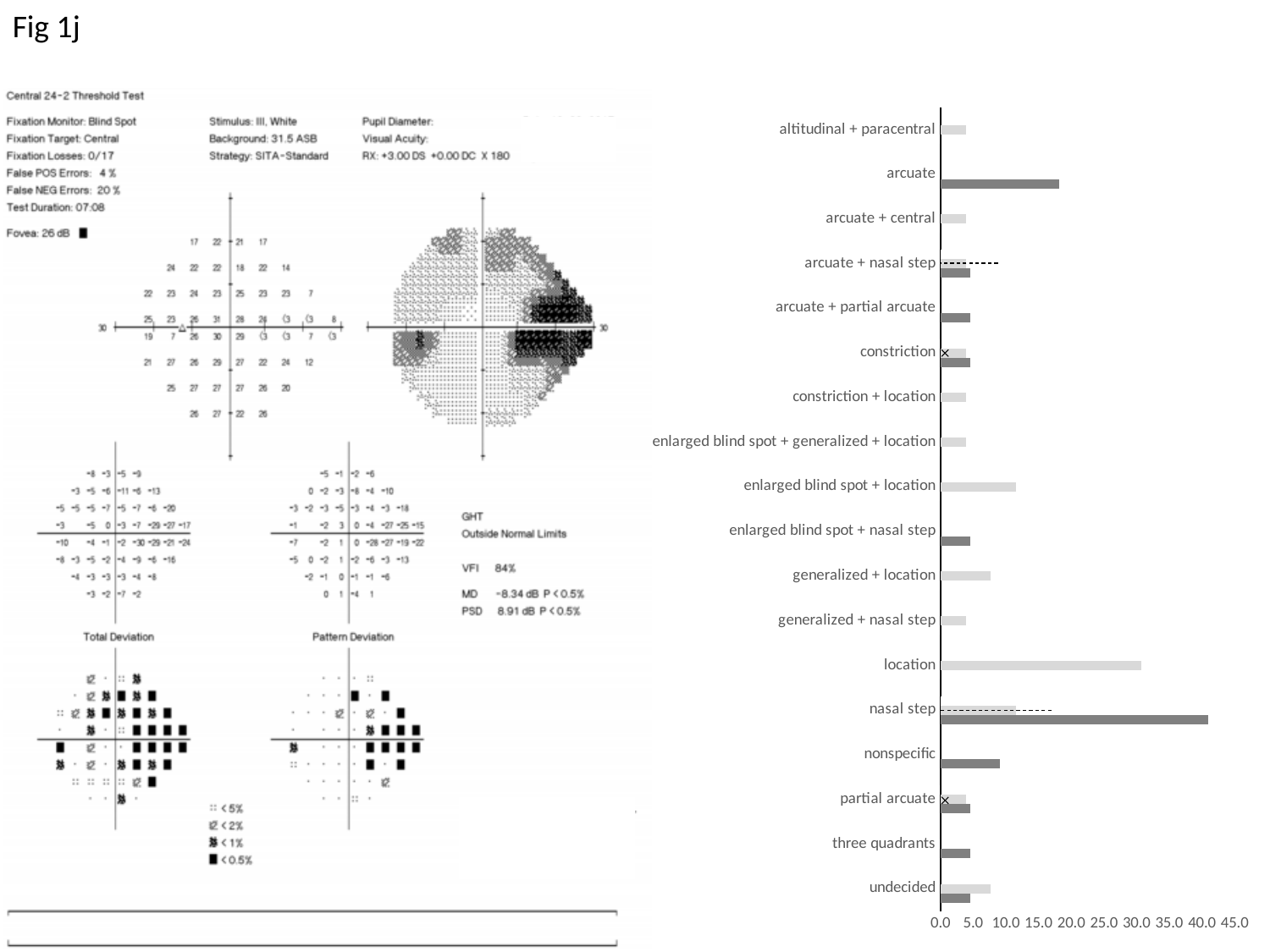
What is the figure label shown at the top left of the slide? Fig 1j Is the value of the bar for altitudinal + paracentral greater or less than 5.0? less Which has the longer bar in the bar chart, arcuate or nonspecific? arcuate Is the value of the bar for nonspecific greater or less than 5.0? greater Is the value of the bar for location greater or less than 25.0? greater What is the highest tick value shown on the horizontal axis of the bar chart? 45.0 Which has the longer bar in the bar chart, nasal step or location? nasal step What kind of chart is shown on the right side of the slide? bar chart Which category has the longest bar in the bar chart? nasal step How many categories are listed on the vertical axis of the bar chart? 18